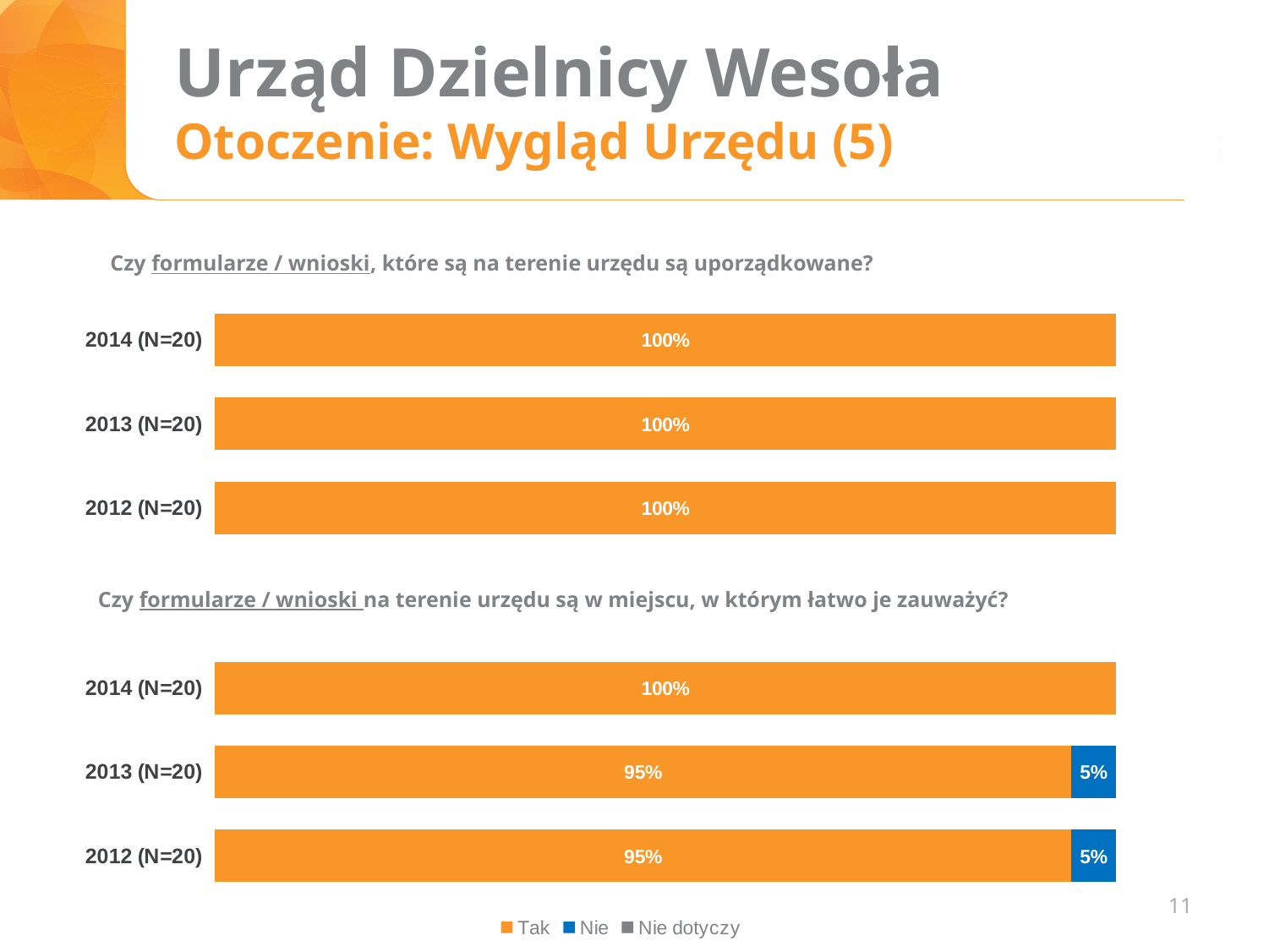
In the bottom chart ("Czy formularze / wnioski na terenie urzędu są w miejscu, w którym łatwo je zauważyć?"), which is larger: the Tak value in 2014 (N=20) or the Tak value in 2012 (N=20)? 2014 (N=20) In the bottom chart ("Czy formularze / wnioski na terenie urzędu są w miejscu, w którym łatwo je zauważyć?"), what is the value for Tak in 2013 (N=20)? 95% In the top chart ("Czy formularze / wnioski, które są na terenie urzędu są uporządkowane?"), what is the value for Tak in 2012 (N=20)? 100% How many year categories does the top chart ("Czy formularze / wnioski, które są na terenie urzędu są uporządkowane?") show? 3 What type of chart is the bottom chart ("Czy formularze / wnioski na terenie urzędu są w miejscu, w którym łatwo je zauważyć?")? Stacked bar chart In the top chart ("Czy formularze / wnioski, które są na terenie urzędu są uporządkowane?"), what is the value for Tak in 2014 (N=20)? 100% In the bottom chart ("Czy formularze / wnioski na terenie urzędu są w miejscu, w którym łatwo je zauważyć?"), what is the value for Tak in 2014 (N=20)? 100% In the bottom chart ("Czy formularze / wnioski na terenie urzędu są w miejscu, w którym łatwo je zauważyć?"), what is the value for Nie in 2012 (N=20)? 5% How many series does the legend at the bottom of the slide list? 3 In the bottom chart ("Czy formularze / wnioski na terenie urzędu są w miejscu, w którym łatwo je zauważyć?"), what is the difference between the Tak value in 2014 (N=20) and the Tak value in 2013 (N=20)? 5% In the bottom chart ("Czy formularze / wnioski na terenie urzędu są w miejscu, w którym łatwo je zauważyć?"), which year has the highest value for Tak? 2014 (N=20) In the bottom chart ("Czy formularze / wnioski na terenie urzędu są w miejscu, w którym łatwo je zauważyć?"), what is the total of the stacked bar for 2013 (N=20)? 100%